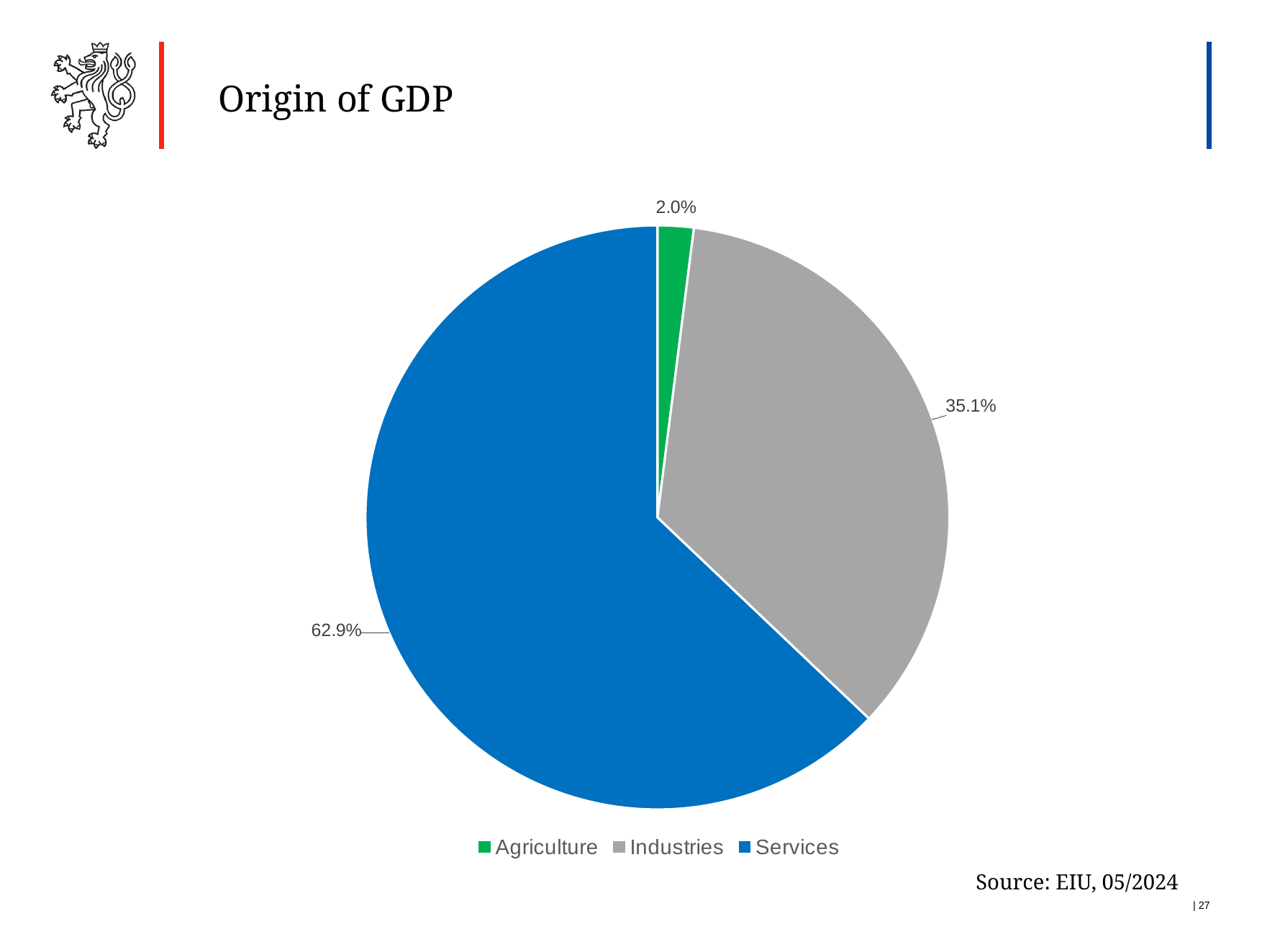
Which sector has the smallest share of GDP? Agriculture What share of GDP comes from Services? 62.9% Which has a larger share of GDP, Industries or Agriculture? Industries What share of GDP comes from Industries? 35.1% What share of GDP comes from Agriculture? 2.0% What is the title of the chart? Origin of GDP What colour is the Services slice? blue Which sector has the largest share of GDP? Services What kind of chart is shown on the slide? pie chart How many entries does the legend list? 3 What is the difference in percentage points between the Services and Industries shares? 27.8 How many sectors are shown in the pie chart? 3